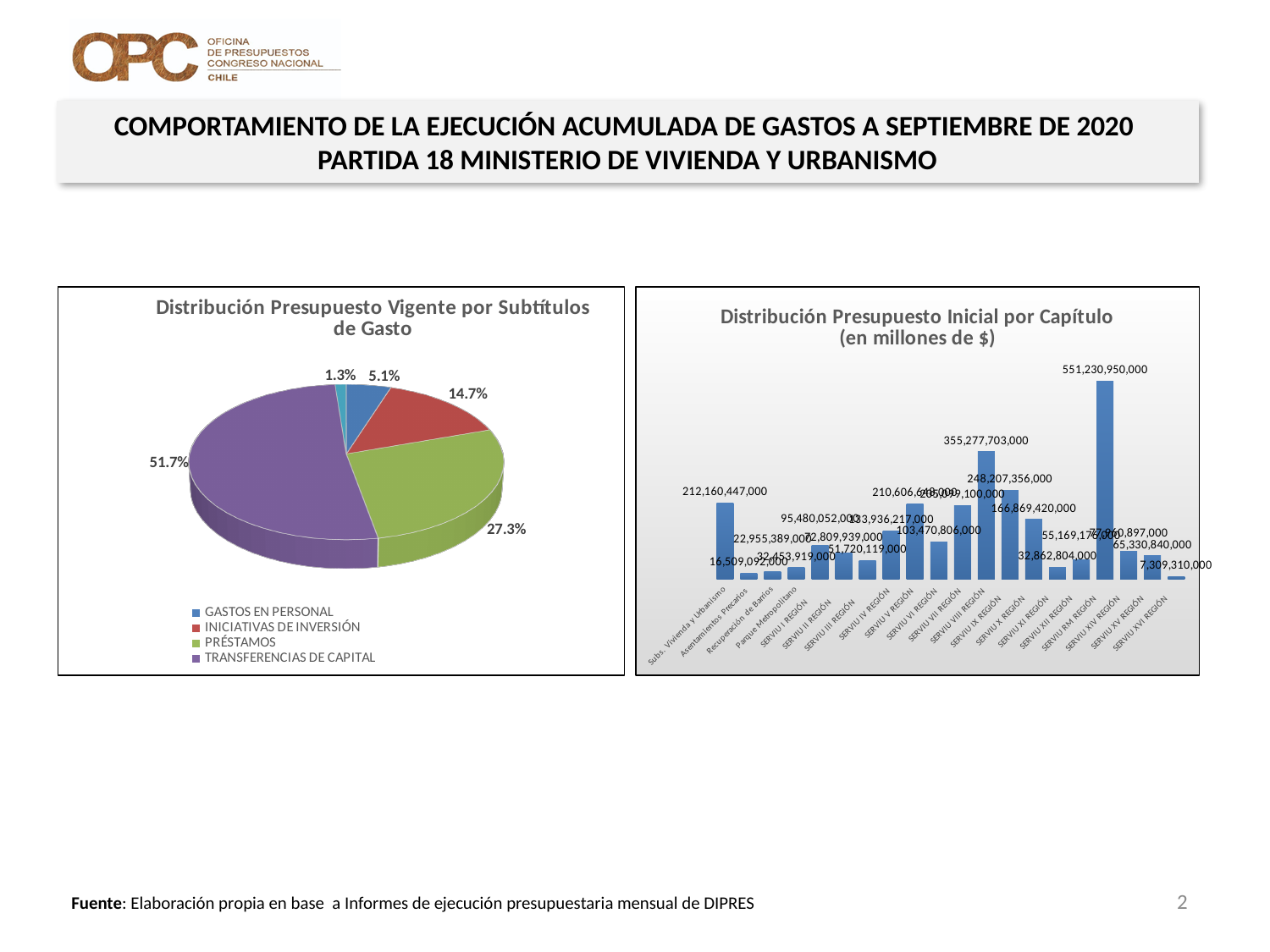
In the pie chart 'Distribución Presupuesto Vigente por Subtítulos de Gasto', which legend category has the largest share? TRANSFERENCIAS DE CAPITAL In the pie chart 'Distribución Presupuesto Vigente por Subtítulos de Gasto', how many entries does the legend list? 4 In the bar chart 'Distribución Presupuesto Inicial por Capítulo', which capítulo has the lowest value? SERVIU XVI REGIÓN In the bar chart 'Distribución Presupuesto Inicial por Capítulo', which is larger: SERVIU IX REGIÓN or SERVIU X REGIÓN? SERVIU IX REGIÓN In the bar chart 'Distribución Presupuesto Inicial por Capítulo', which capítulo has the highest value? SERVIU RM REGIÓN What kind of chart is the left chart, 'Distribución Presupuesto Vigente por Subtítulos de Gasto'? Pie chart What kind of chart is the right chart, 'Distribución Presupuesto Inicial por Capítulo'? Bar chart In the bar chart 'Distribución Presupuesto Inicial por Capítulo', what is the value for Subs. Vivienda y Urbanismo? 212,160,447,000 In the bar chart 'Distribución Presupuesto Inicial por Capítulo', what is the value for SERVIU VIII REGIÓN? 355,277,703,000 In the pie chart 'Distribución Presupuesto Vigente por Subtítulos de Gasto', what share does TRANSFERENCIAS DE CAPITAL have? 51.7% In the pie chart 'Distribución Presupuesto Vigente por Subtítulos de Gasto', what share does PRÉSTAMOS have? 27.3% In the pie chart 'Distribución Presupuesto Vigente por Subtítulos de Gasto', what is the difference in percentage points between TRANSFERENCIAS DE CAPITAL and PRÉSTAMOS? 24.4 percentage points